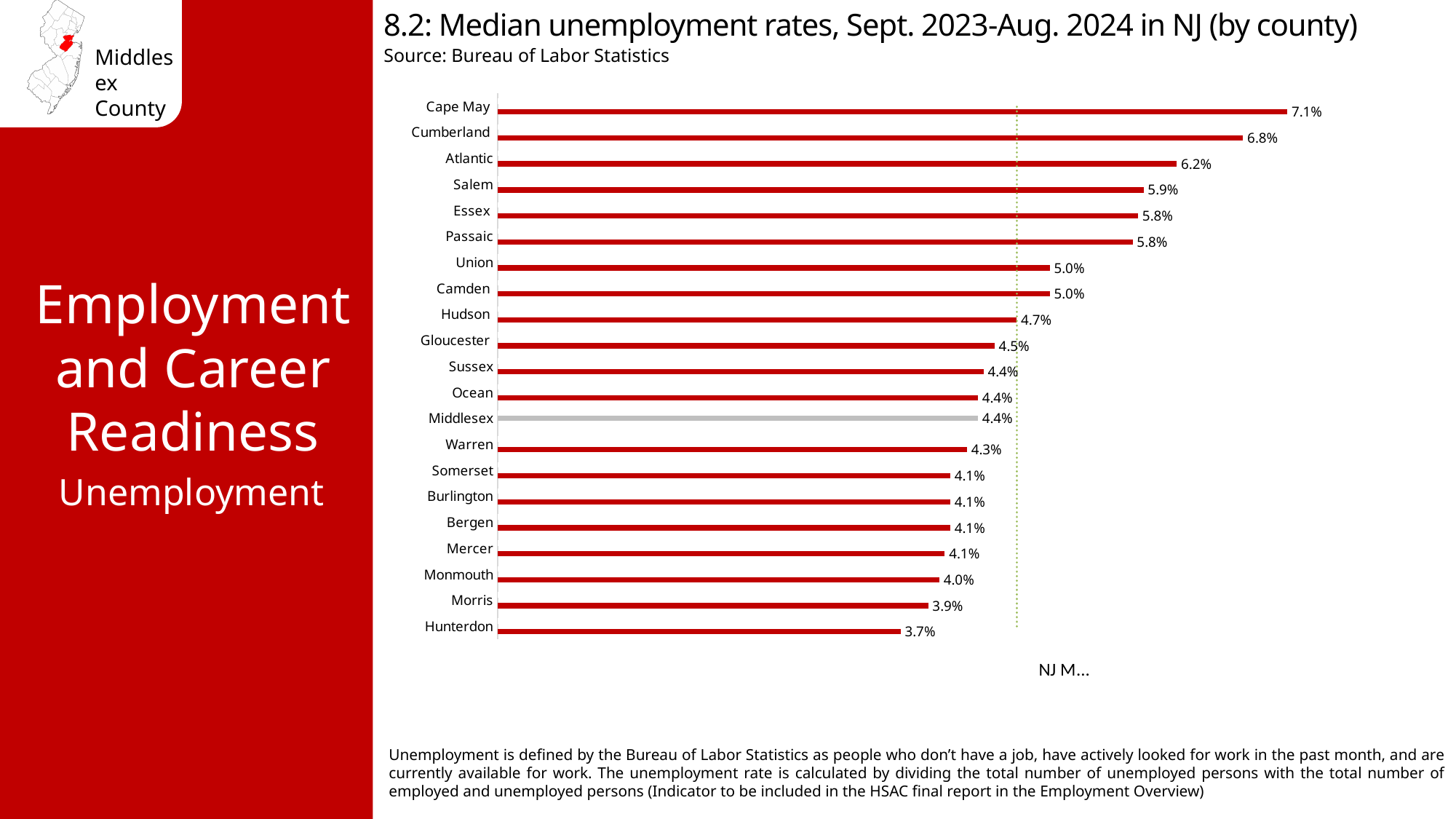
What is the difference between the median unemployment rates of Cumberland and Middlesex? 2.4% What is the median unemployment rate for Hunterdon? 3.7% Which county has the lowest median unemployment rate? Hunterdon What is the difference between the median unemployment rates of Cape May and Hunterdon? 3.4% What is the median unemployment rate for Middlesex County? 4.4% Which county has a higher median unemployment rate, Atlantic or Union? Atlantic What is the median unemployment rate for Cape May? 7.1% What type of chart is used to show the median unemployment rates? Bar chart Which county has a higher median unemployment rate, Morris or Warren? Warren Which county has the highest median unemployment rate? Cape May Which county's bar is shown in grey instead of red? Middlesex How many counties are shown in the chart? 21